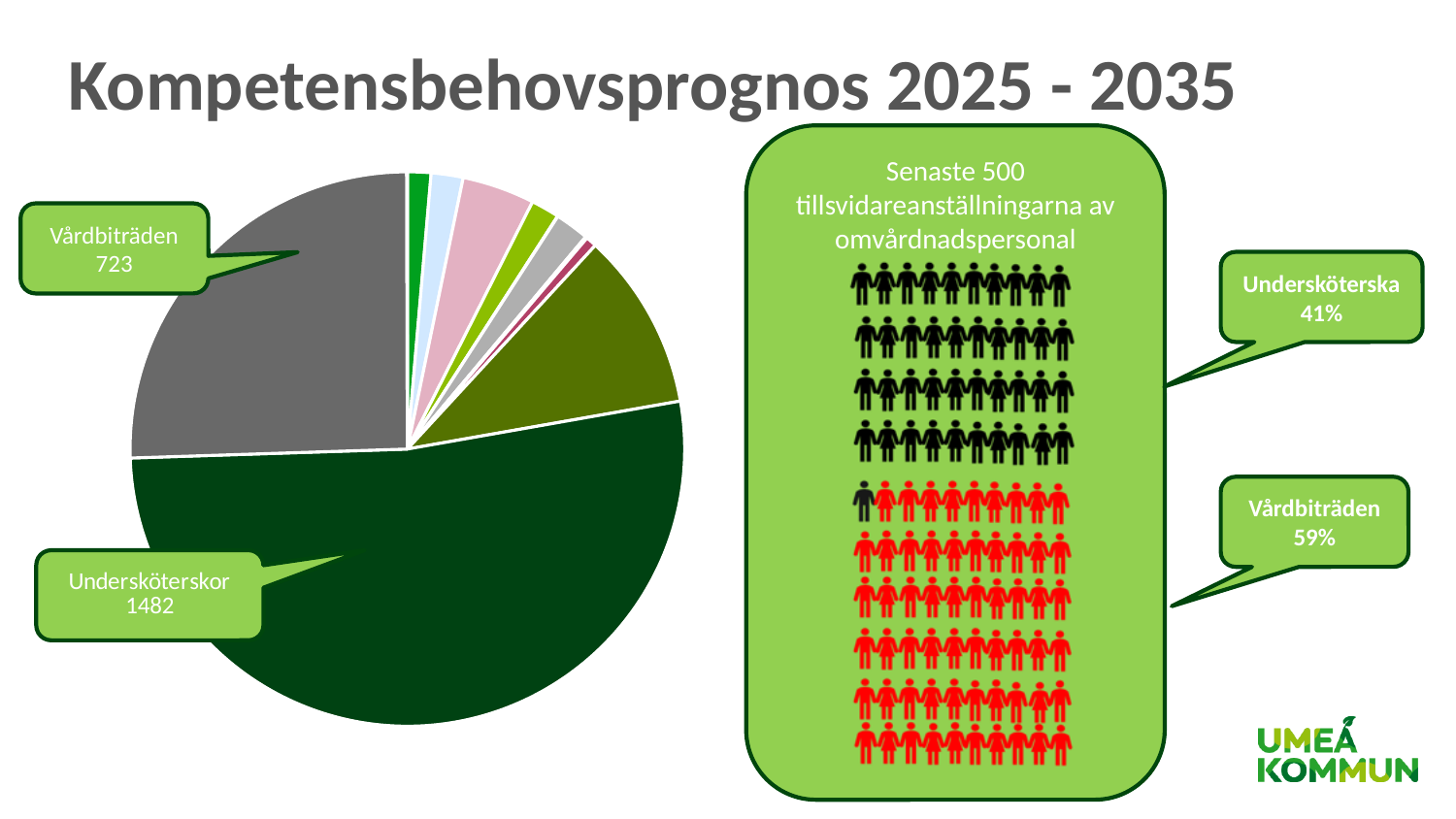
In the pie chart, what is the value for Vårdbiträden? 723 In the pie chart, which category has the largest slice? Undersköterskor In the pictogram on the right, which group has the larger share, Undersköterska or Vårdbiträden? Vårdbiträden What is the title of the slide? Kompetensbehovsprognos 2025 - 2035 In the pie chart, what is the difference between the values for Undersköterskor and Vårdbiträden? 759 In the pie chart, what is the value for Undersköterskor? 1482 In the pictogram on the right, what is the difference in percentage points between Vårdbiträden and Undersköterska? 18 percentage points In the pie chart, which labeled category has the larger value, Undersköterskor or Vårdbiträden? Undersköterskor In the pictogram on the right, what share is shown for Vårdbiträden? 59% What is the title of the pictogram on the right side of the slide? Senaste 500 tillsvidareanställningarna av omvårdnadspersonal In the pictogram on the right, what share is shown for Undersköterska? 41% What kind of chart is shown on the left side of the slide? Pie chart